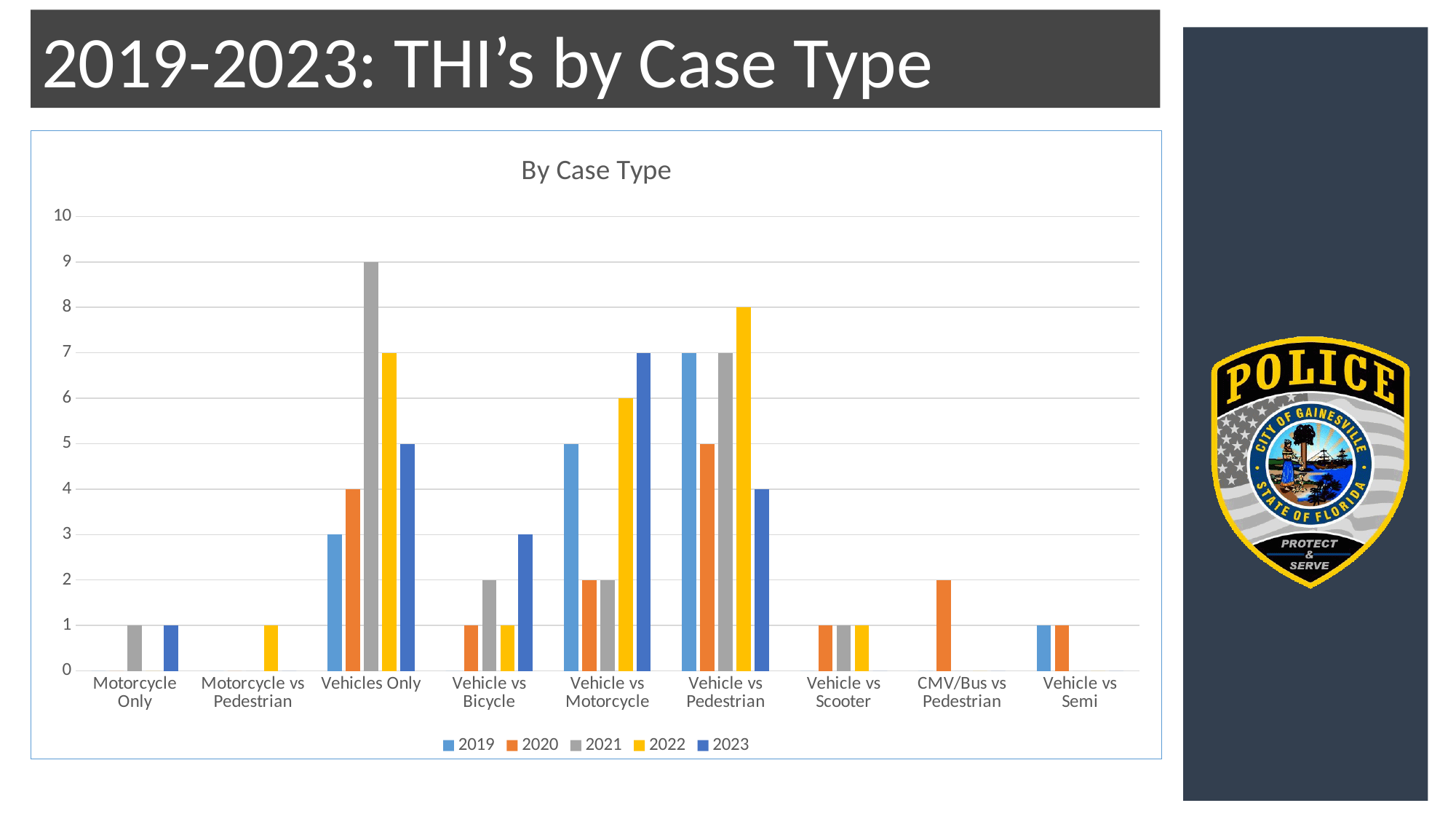
Which is larger for Vehicle vs Pedestrian: the 2019 value or the 2023 value? 2019 How many series does the legend list? 5 Is the 2022 value for Vehicle vs Motorcycle greater or less than 5? greater What is the 2021 value for Vehicles Only? 9 How many case type categories are shown on the x axis? 9 What is the 2023 value for Vehicle vs Motorcycle? 7 What is the difference between the 2021 and 2019 values for Vehicles Only? 6 Which case type has the highest 2022 value? Vehicle vs Pedestrian What kind of chart is shown on the slide? Bar chart What is the 2020 value for CMV/Bus vs Pedestrian? 2 What is the 2022 value for Vehicle vs Pedestrian? 8 Which case type has the highest 2021 value? Vehicles Only